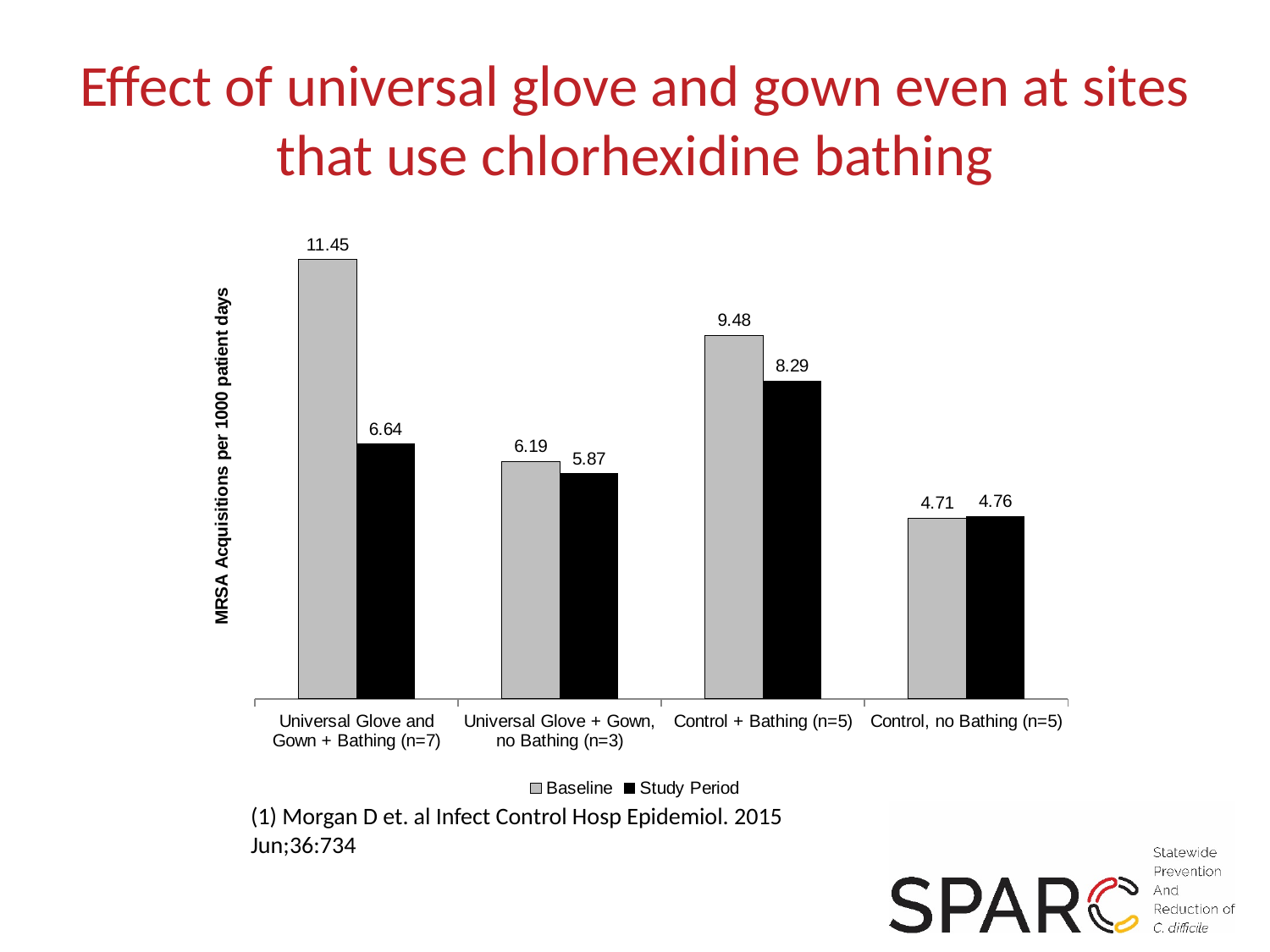
How many categories are shown on the x axis? 4 What is the Study Period value for Universal Glove + Gown, no Bathing (n=3)? 5.87 Which is larger, the Baseline value for Control + Bathing (n=5) or the Baseline value for Universal Glove + Gown, no Bathing (n=3)? Control + Bathing (n=5) How many series does the legend list? 2 What is the Study Period value for Control + Bathing (n=5)? 8.29 Which category has the highest Baseline value? Universal Glove and Gown + Bathing (n=7) Which category has the lowest Study Period value? Control, no Bathing (n=5) What is the Baseline value for Universal Glove and Gown + Bathing (n=7)? 11.45 What is the Baseline value for Control, no Bathing (n=5)? 4.71 What is the difference between the Baseline and Study Period values for Control + Bathing (n=5)? 1.19 What is the difference between the Baseline and Study Period values for Universal Glove and Gown + Bathing (n=7)? 4.81 What kind of chart is shown on the slide? Bar chart